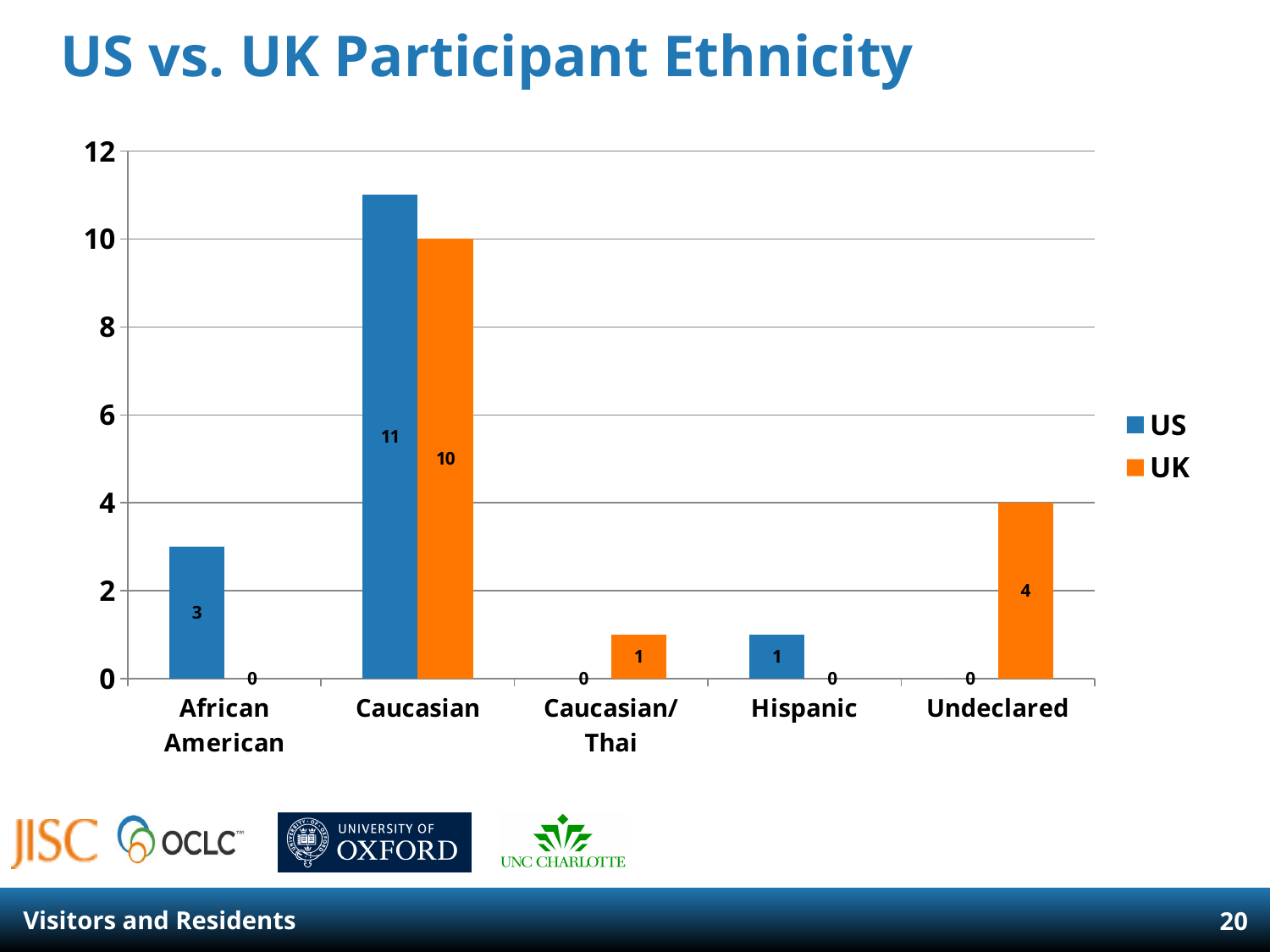
What is the UK value for Undeclared participants? 4 How many series does the legend list? 2 Which ethnicity category has the highest UK value? Caucasian What is the UK value for Caucasian/Thai participants? 1 What is the US value for African American participants? 3 What is the difference between the US and UK values for Caucasian participants? 1 What is the US value for Caucasian participants? 11 Which is larger, the US value for Hispanic or the UK value for Undeclared? UK value for Undeclared What is the title of the chart? US vs. UK Participant Ethnicity Which ethnicity category has the highest US value? Caucasian How many ethnicity categories are shown on the x axis? 5 What kind of chart is shown on the slide? Bar chart